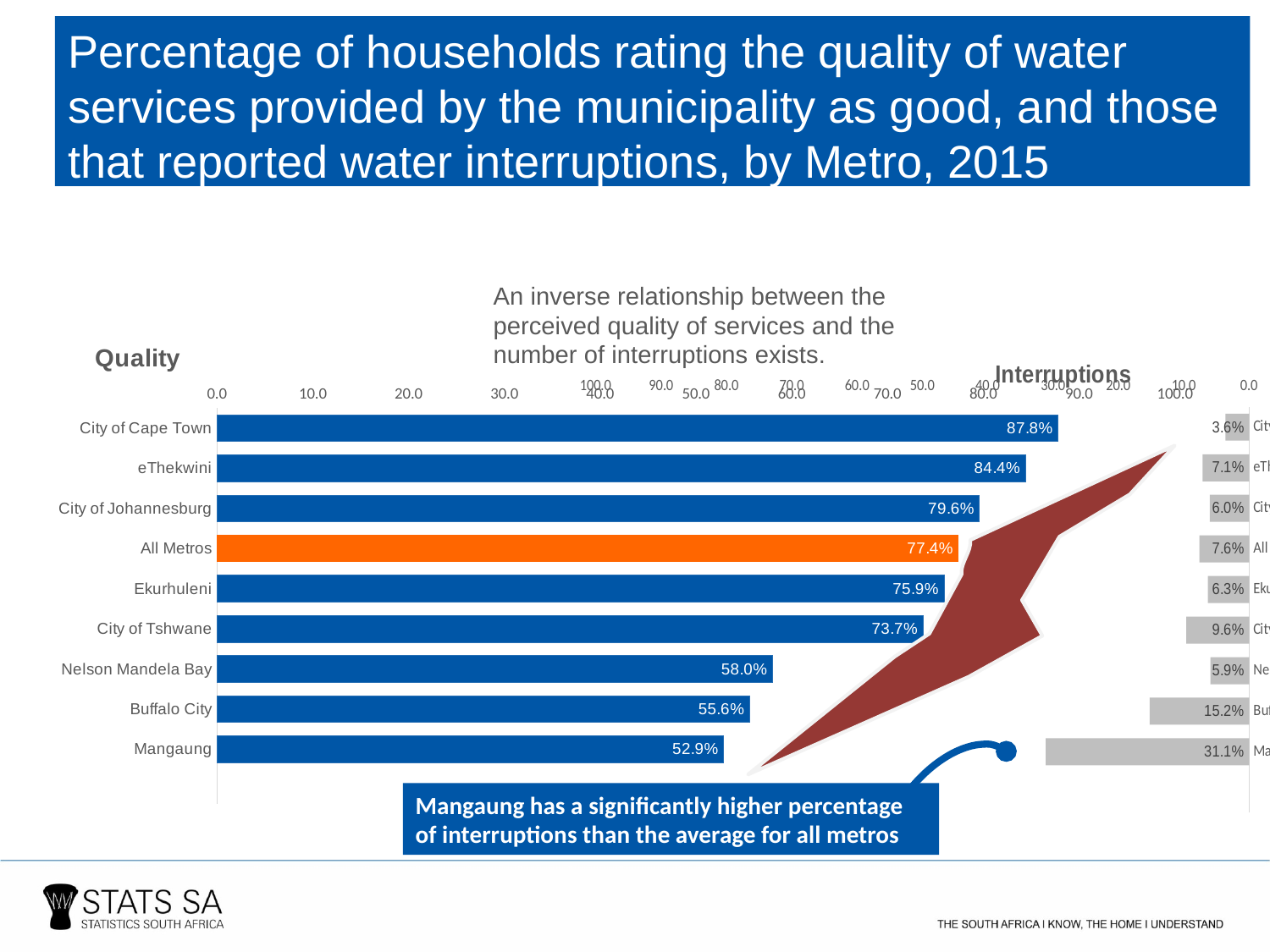
In the Quality chart, which metro has the highest percentage? City of Cape Town In the Interruptions chart, what is the value for the top bar (City of Cape Town)? 3.6% How many categories (bars) are shown in the Quality chart? 9 In the Quality chart, what is the value for Nelson Mandela Bay? 58.0% In the Quality chart, what is the value for All Metros? 77.4% In the Interruptions chart, what is the value for Mangaung (the bottom bar)? 31.1% In the Quality chart, which metro has the lowest percentage of households rating water services as good? Mangaung In the Quality chart, what is the difference between eThekwini and Buffalo City? 28.8 percentage points In the Quality chart, what percentage of households in the City of Cape Town rated water services as good? 87.8% What type of chart is the Quality chart? Bar chart In the Quality chart, which is larger: City of Johannesburg or Ekurhuleni? City of Johannesburg In the Quality chart, which bar is coloured orange rather than blue? All Metros